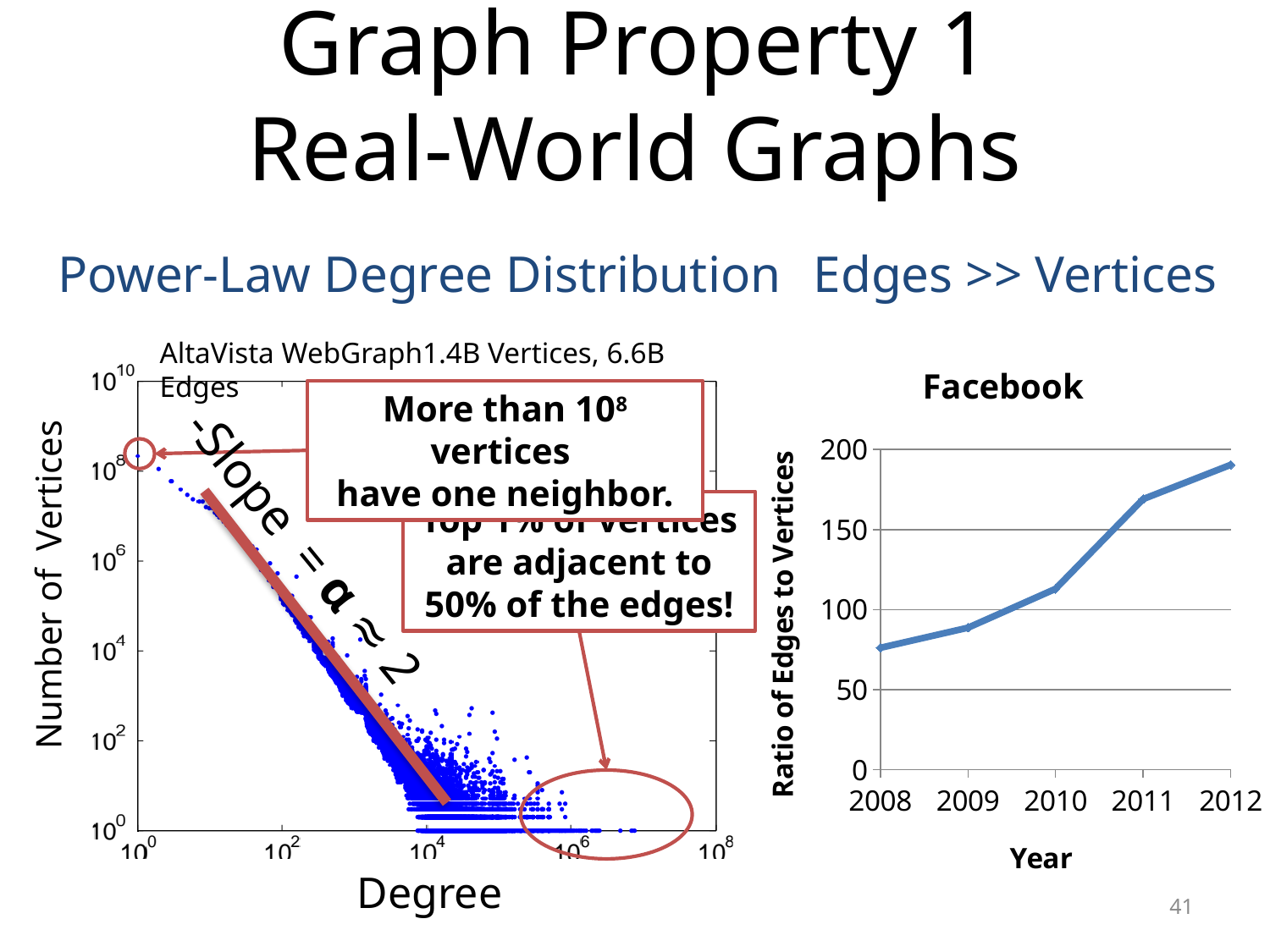
On the Facebook chart, is the ratio of edges to vertices in 2009 greater or less than 100? less On the Facebook chart, is the ratio of edges to vertices in 2012 greater or less than 150? greater On the Facebook chart, is the ratio of edges to vertices in 2008 greater or less than 100? less On the Facebook chart, is the ratio of edges to vertices larger in 2011 or in 2009? 2011 On the Facebook chart, which year has the lowest ratio of edges to vertices? 2008 What is the label of the x axis on the left-hand AltaVista WebGraph chart? Degree On the Facebook chart, how many years are plotted on the x axis? 5 What is the label of the y axis on the Facebook chart? Ratio of Edges to Vertices On the Facebook chart, which year has the highest ratio of edges to vertices? 2012 What kind of chart is the Facebook chart on the right? line chart On the Facebook chart, does the ratio of edges to vertices rise or fall from 2008 to 2012? rise